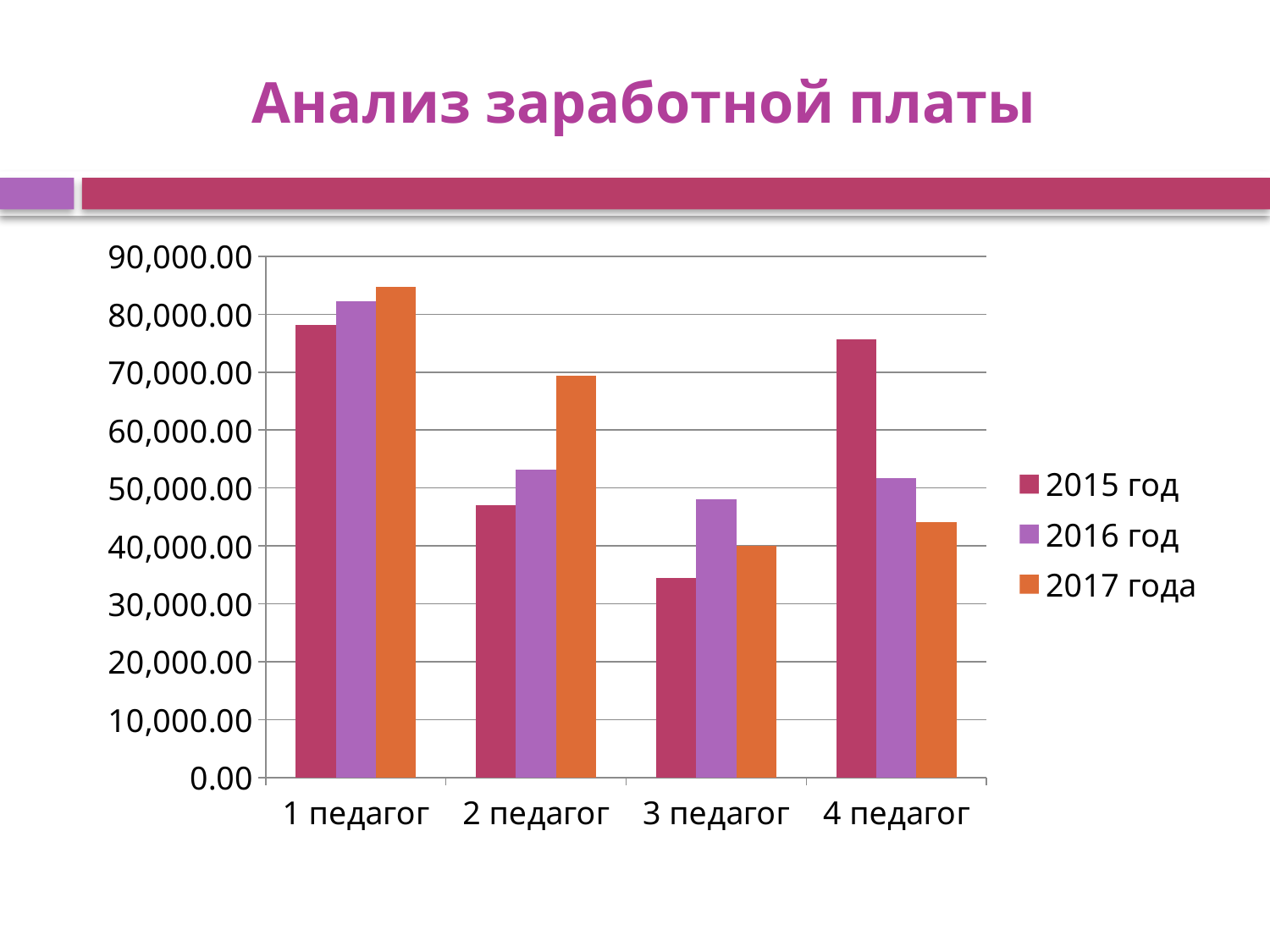
How many categories are shown on the x axis? 4 Which category has the highest value for the 2017 года series? 1 педагог How many series does the legend list? 3 Is the 2016 год value for 4 педагог greater or less than 60,000.00? less Is the 2017 года value for 2 педагог greater or less than 60,000.00? greater For 1 педагог, do the values rise or fall from 2015 год to 2017 года? rise For 4 педагог, which is larger: the 2015 год value or the 2017 года value? 2015 год What kind of chart is shown on the slide? bar chart Is the 2015 год value for 3 педагог greater or less than 40,000.00? less Which category has the lowest value for the 2015 год series? 3 педагог For 4 педагог, do the values rise or fall from 2015 год to 2017 года? fall What is the title of the slide? Анализ заработной платы